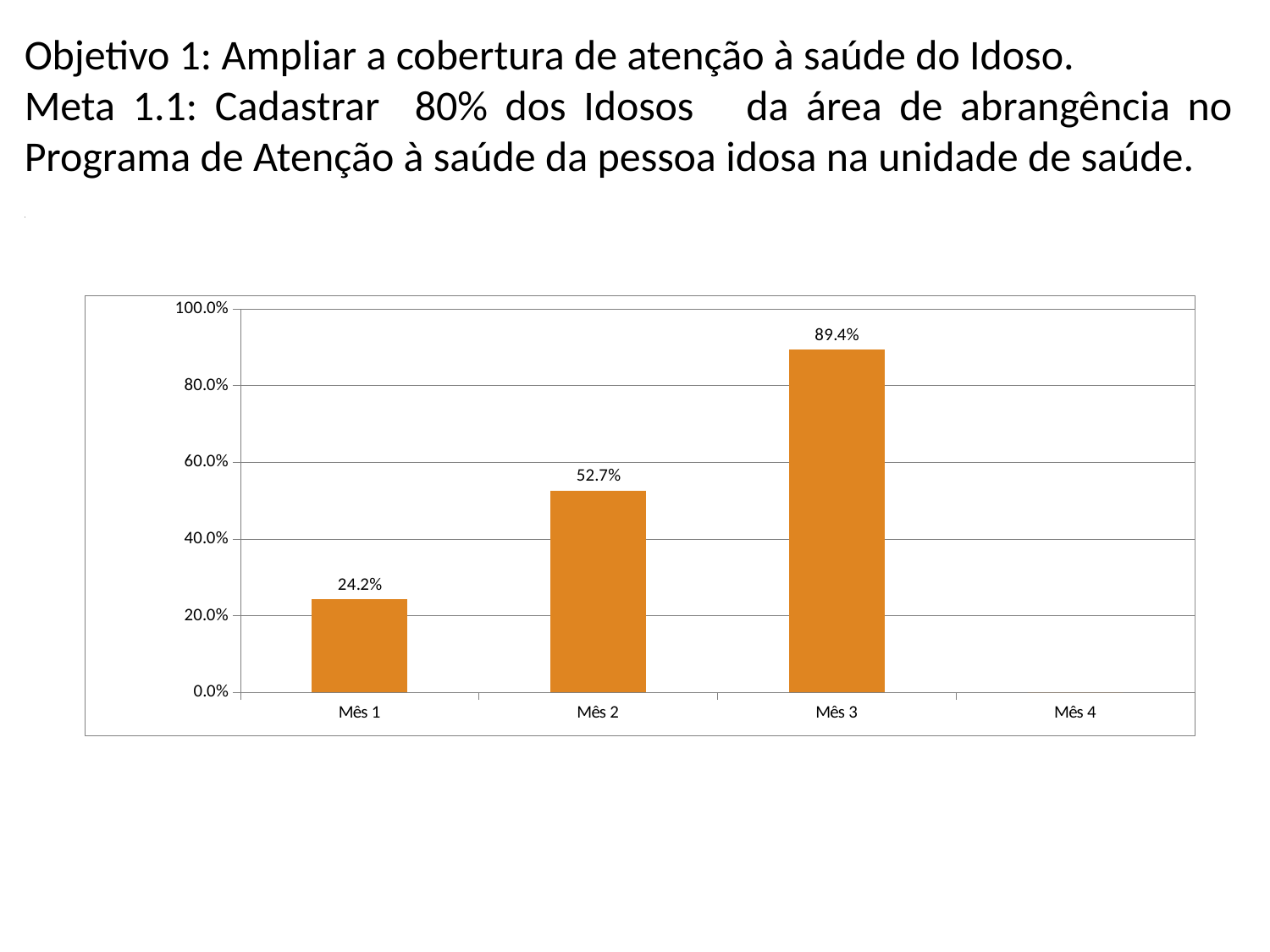
Is the value for Mês 3 greater or less than 80.0%? greater Do the values rise or fall from Mês 1 to Mês 3? rise What is the value for Mês 3? 89.4% Among the months with a plotted bar, which has the lowest value? Mês 1 What is the difference between the values for Mês 2 and Mês 1? 28.5% How many categories are shown on the x axis? 4 Which is larger, the value for Mês 1 or the value for Mês 2? Mês 2 What is the value for Mês 1? 24.2% What is the value for Mês 2? 52.7% Which month has the highest value? Mês 3 What kind of chart is shown on the slide? bar chart What is the difference between the values for Mês 3 and Mês 2? 36.7%